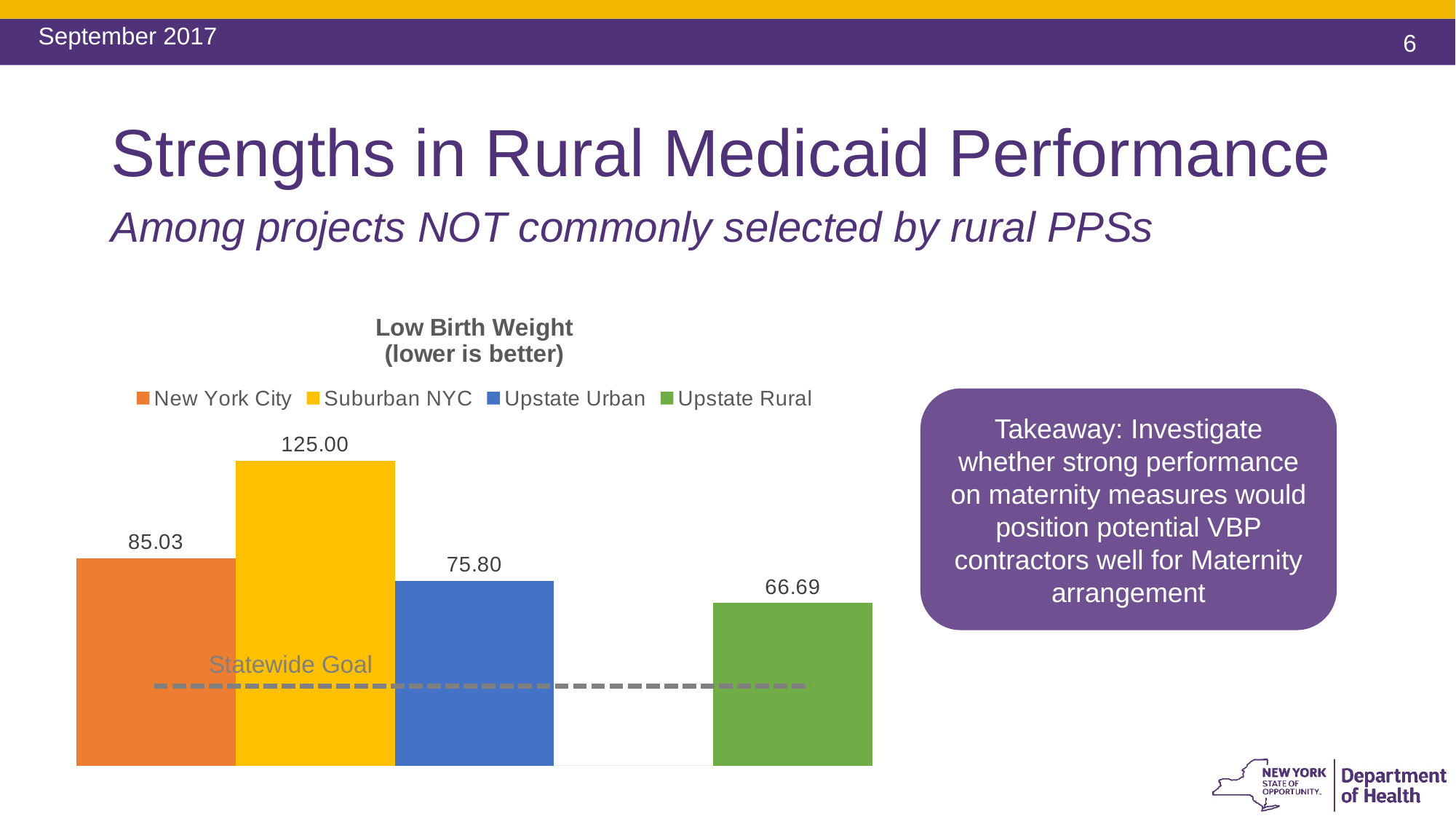
Which region has the highest Low Birth Weight value? Suburban NYC What is the Low Birth Weight value for New York City? 85.03 What is the difference between the New York City and Upstate Urban values? 9.23 What is the difference between the Suburban NYC and Upstate Rural values? 58.31 Which region has the lowest Low Birth Weight value? Upstate Rural Which is larger, the value for New York City or the value for Upstate Urban? New York City What is the title of the chart? Low Birth Weight (lower is better) What is the Low Birth Weight value for Upstate Rural? 66.69 What is the Low Birth Weight value for Suburban NYC? 125.00 How many series does the legend list? 4 What is the Low Birth Weight value for Upstate Urban? 75.80 What kind of chart is shown on the slide? Bar chart